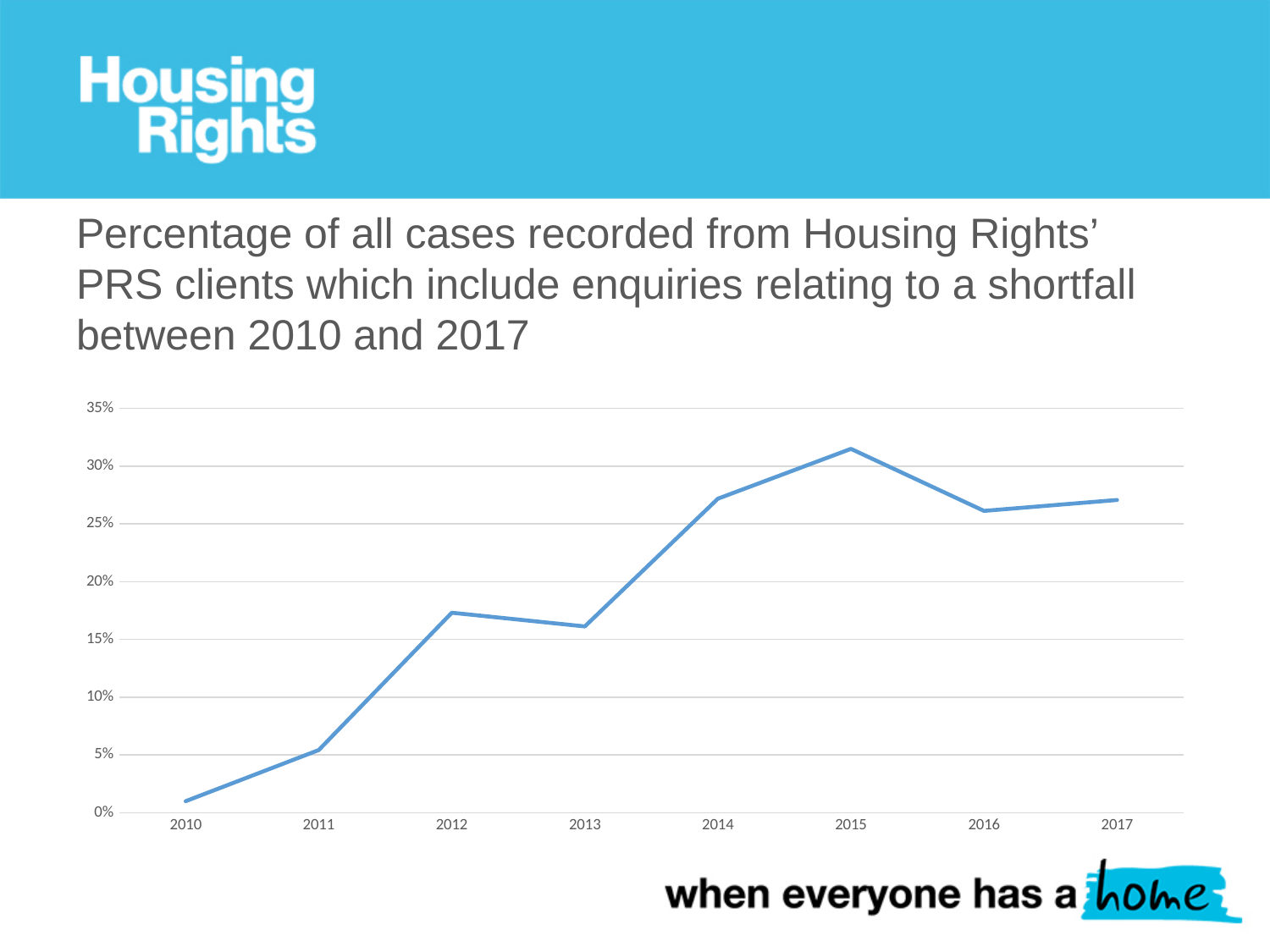
Which year has the higher percentage, 2011 or 2012? 2012 Overall, does the percentage rise or fall from 2010 to 2017? rise What kind of chart is shown on the slide? line chart How many years are plotted along the x axis of the chart? 8 In which year does the chart reach its highest percentage? 2015 Is the value for 2013 greater or less than 20%? less Is the value for 2011 greater or less than 10%? less Is the value for 2014 greater or less than 25%? greater Does the percentage rise or fall between 2015 and 2016? fall In which year does the chart show its lowest percentage? 2010